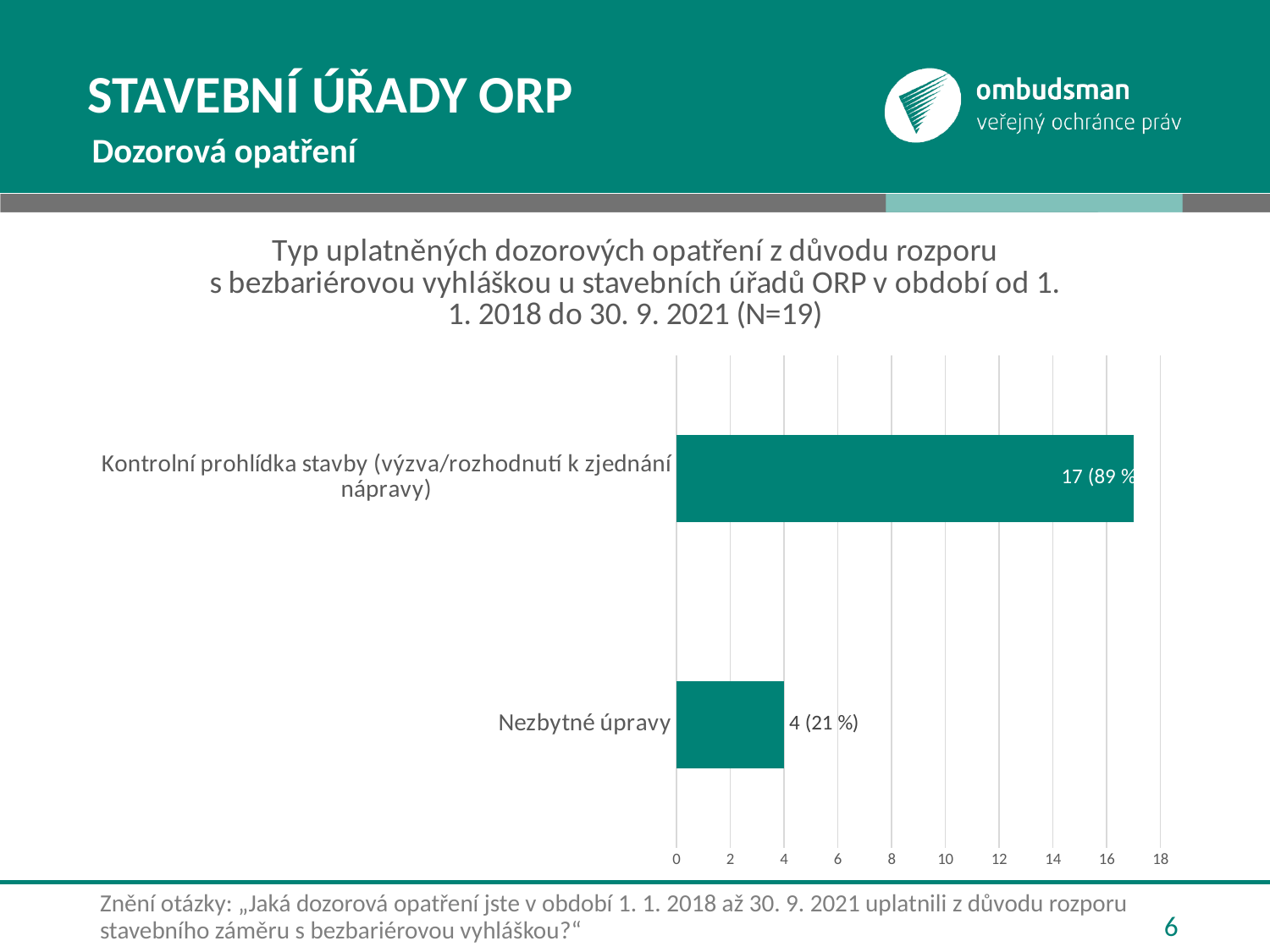
How many categories are shown in the chart? 2 Which category has the highest value? Kontrolní prohlídka stavby (výzva/rozhodnutí k zjednání nápravy) What is the N value stated in the chart title? N=19 Is the value for Kontrolní prohlídka stavby greater or less than 16? greater Which is larger: the value for Nezbytné úpravy or for Kontrolní prohlídka stavby? Kontrolní prohlídka stavby What value is shown for Nezbytné úpravy? 4 (21 %) What kind of chart is shown on the slide? Bar chart Is the value for Nezbytné úpravy greater or less than 6? less What is the difference in count between Kontrolní prohlídka stavby and Nezbytné úpravy? 13 What percentage is shown for Kontrolní prohlídka stavby (výzva/rozhodnutí k zjednání nápravy)? 89 % How many building authorities applied Kontrolní prohlídka stavby (výzva/rozhodnutí k zjednání nápravy)? 17 Which category has the lowest value? Nezbytné úpravy